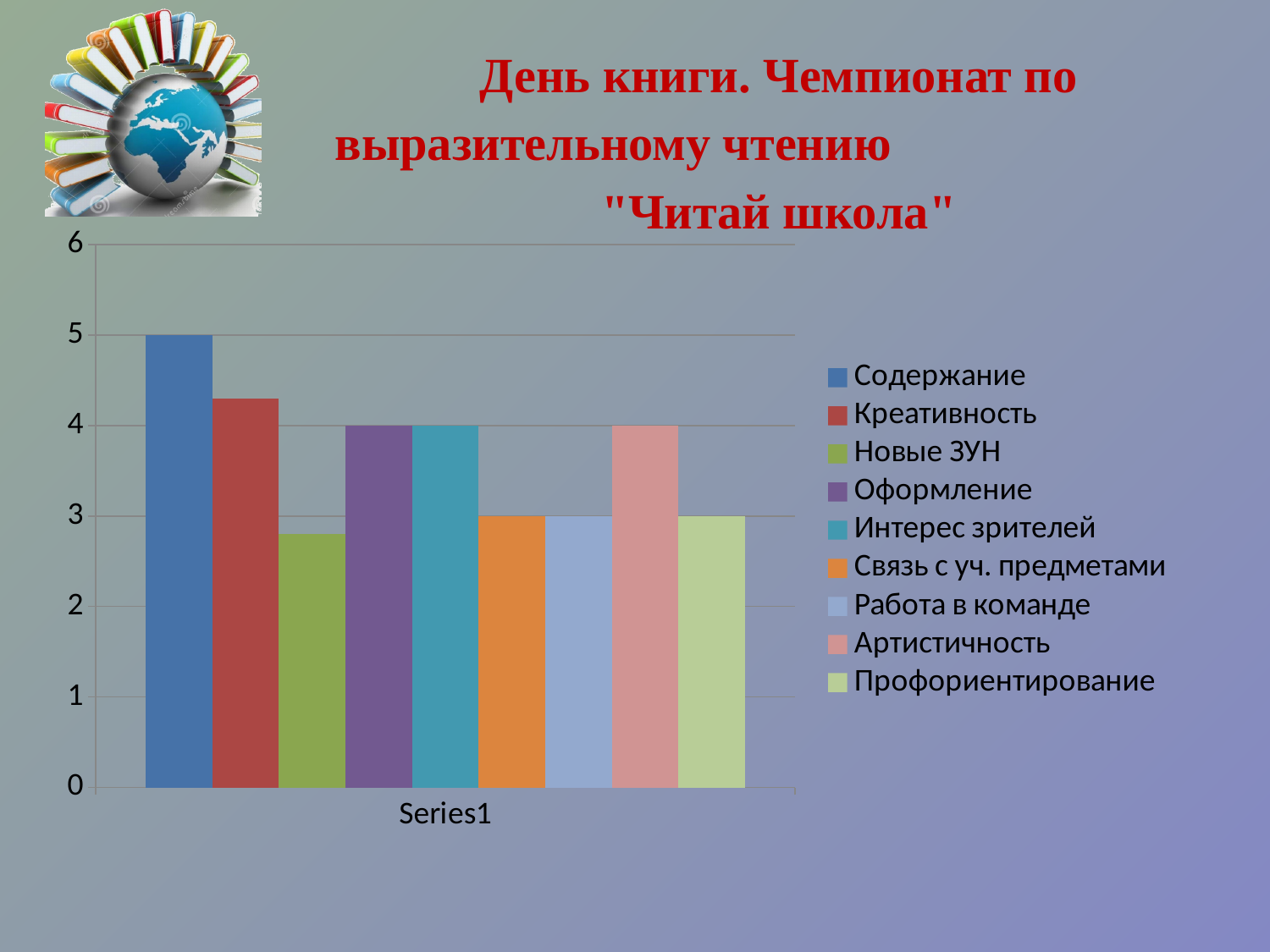
What is the difference between the value for Содержание and the value for Профориентирование? 2 How many series does the legend list? 9 What is the value for Оформление? 4 What is the value for Содержание? 5 What is the value for Артистичность? 4 Is the value for Креативность greater or less than 4? greater Which series has the highest value? Содержание Which is larger, the value for Креативность or the value for Работа в команде? Креативность What kind of chart is shown on the slide? bar chart Is the value for Новые ЗУН greater or less than 3? less What is the value for Связь с уч. предметами? 3 Which series has the lowest value? Новые ЗУН